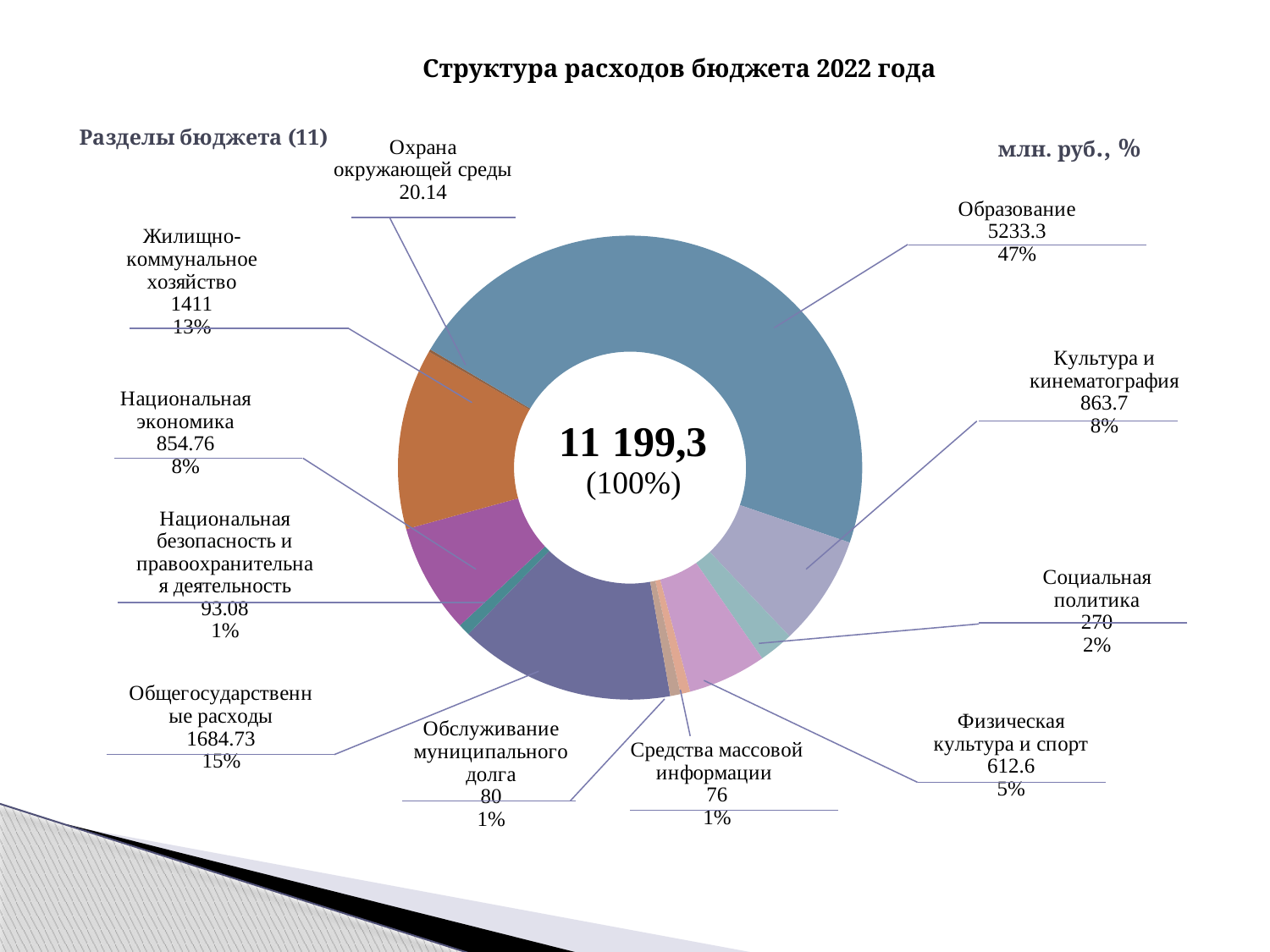
What is the value shown for Образование? 5233.3 Which budget section has the smallest value on the chart? Охрана окружающей среды What percentage share is shown for Физическая культура и спорт? 5% Which budget section has the largest share of the chart? Образование What type of chart is shown on the slide? Doughnut (pie) chart What is the title of the chart? Разделы бюджета (11) Which is larger: the value for Культура и кинематография or the value for Национальная экономика? Культура и кинематография What total value is shown in the centre of the chart? 11 199,3 What is the difference between the values for Общегосударственные расходы and Жилищно-коммунальное хозяйство? 273.73 What percentage share is shown for Жилищно-коммунальное хозяйство? 13% How many budget sections are shown on the chart? 11 What is the value shown for Охрана окружающей среды? 20.14